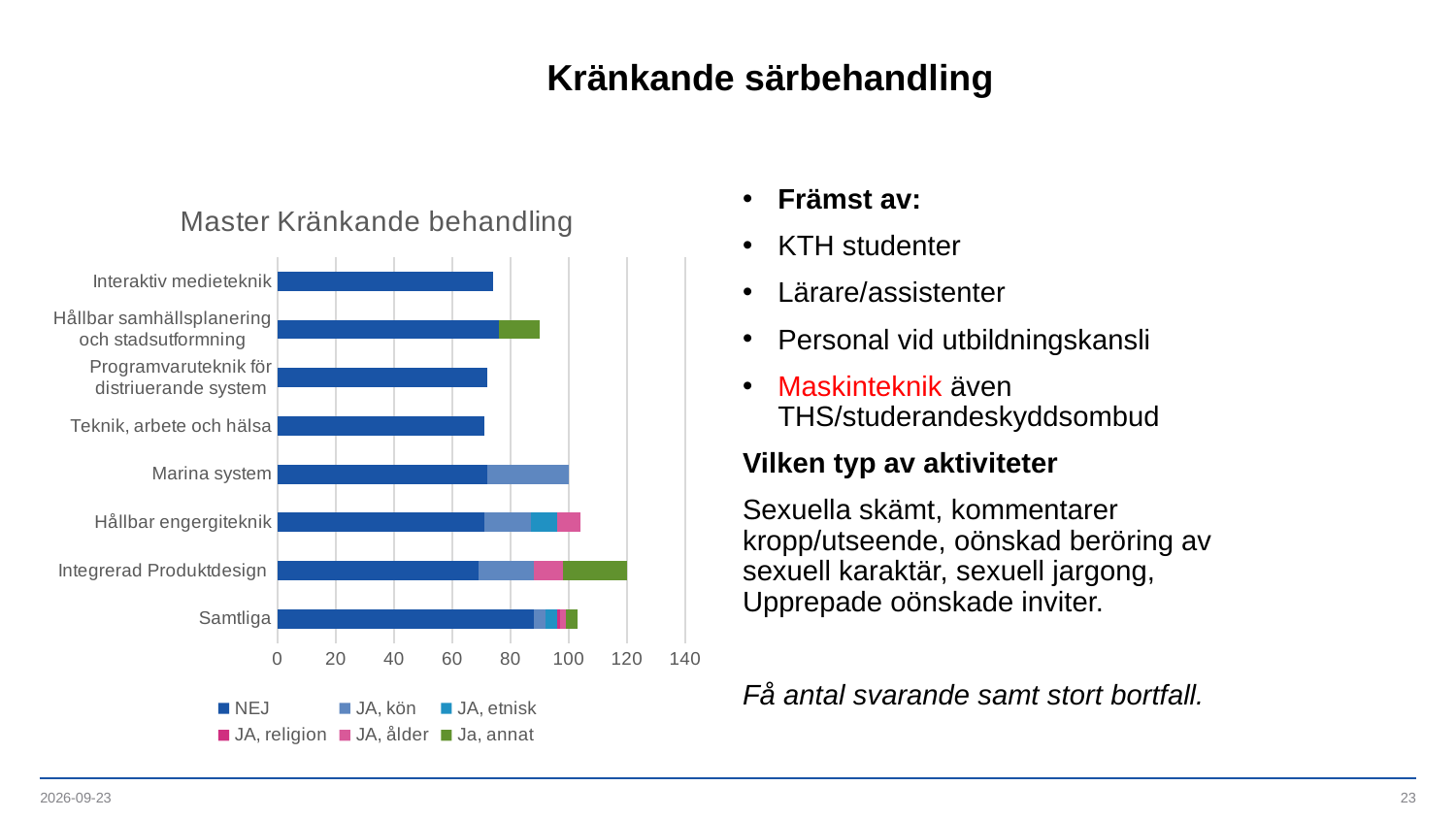
Is the total bar length for Programvaruteknik för distriuerande system greater or less than 80? less Is the total bar length for Interaktiv medieteknik greater or less than 80? less How many series does the chart's legend list? 6 What kind of chart is shown on the slide? Bar chart Which series is listed first in the chart's legend? NEJ Which has the longer total bar: Integrerad Produktdesign or Interaktiv medieteknik? Integrerad Produktdesign How many categories are shown on the chart's vertical axis? 8 Which has the longer total bar: Hållbar samhällsplanering och stadsutformning or Teknik, arbete och hälsa? Hållbar samhällsplanering och stadsutformning Is the total bar length for Hållbar samhällsplanering och stadsutformning greater or less than 80? greater Which category has the longest total bar in the chart? Integrerad Produktdesign What is the title of the chart? Master Kränkande behandling